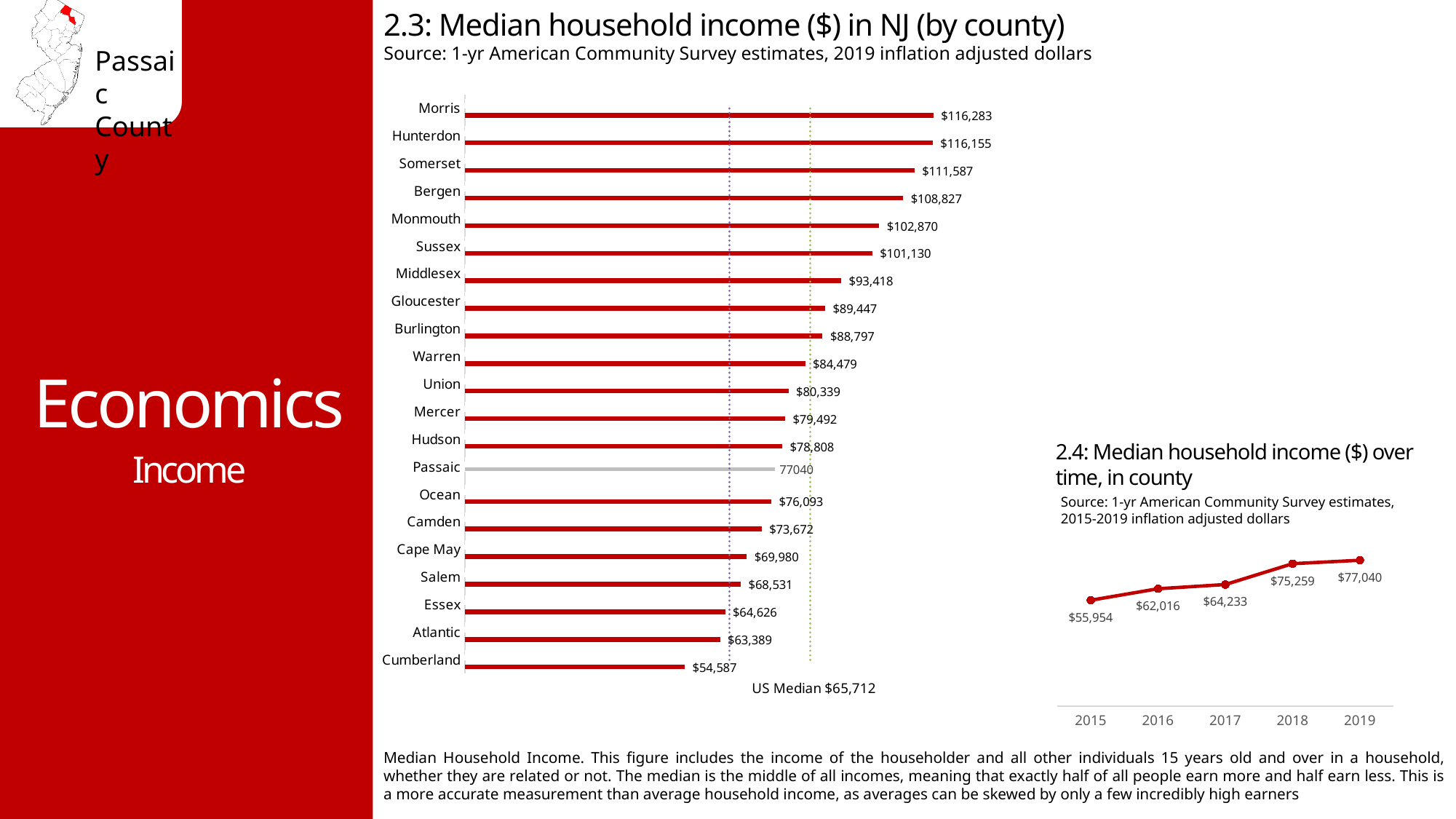
What kind of chart is '2.3: Median household income ($) in NJ (by county)'? Bar chart In the chart '2.3: Median household income ($) in NJ (by county)', which county has the lowest median household income? Cumberland In the chart '2.3: Median household income ($) in NJ (by county)', what is the median household income for Bergen? $108,827 In the chart '2.3: Median household income ($) in NJ (by county)', which county has the highest median household income? Morris In the chart '2.4: Median household income ($) over time, in county', what is the value for 2017? $64,233 In the chart '2.3: Median household income ($) in NJ (by county)', what is the difference between the values for Morris and Cumberland? $61,696 In the chart '2.3: Median household income ($) in NJ (by county)', which county has a higher median household income, Ocean or Camden? Ocean In the chart '2.4: Median household income ($) over time, in county', what is the difference between the 2019 and 2015 values? $21,086 In the chart '2.3: Median household income ($) in NJ (by county)', what is the value shown for Passaic? 77040 How many data points are plotted in the chart '2.4: Median household income ($) over time, in county'? 5 How many counties are shown in the chart '2.3: Median household income ($) in NJ (by county)'? 21 In the chart '2.4: Median household income ($) over time, in county', do the values rise or fall from 2015 to 2019? Rise